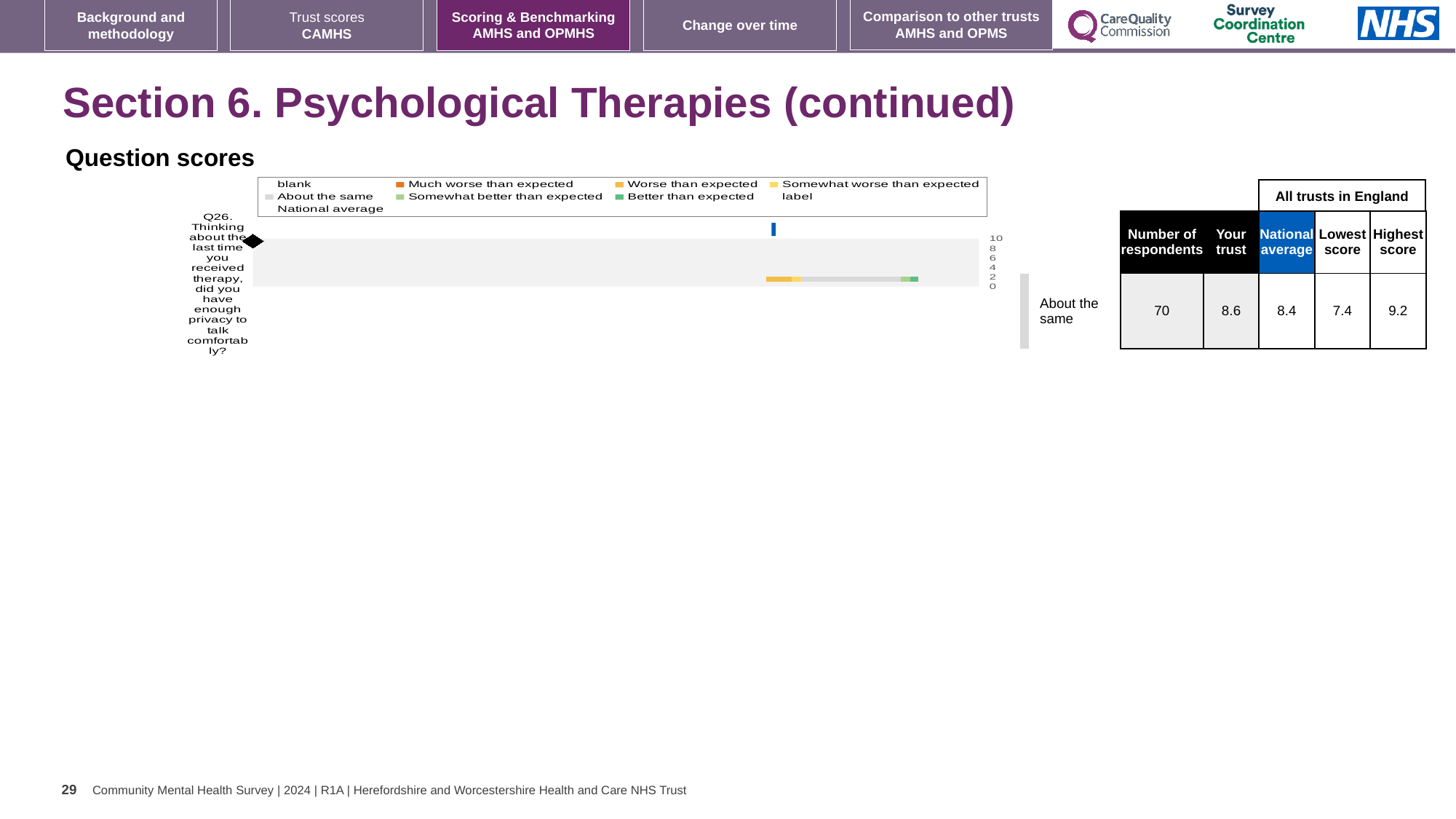
How many respondents answered Q26, according to the table beside the chart? 70 According to the table beside the chart, what is the 'Your trust' score for Q26? 8.6 What is the highest value shown on the chart's score axis? 10 What kind of chart is used to show the Q26 question score? bar chart According to the table beside the chart, what is the lowest score among all trusts in England for Q26? 7.4 Is the trust's score for Q26 higher or lower than the national average? higher What benchmark category is the trust's Q26 score placed in? About the same How many questions are plotted on the chart? 1 What is the difference between the highest score and the lowest score for Q26 in the table beside the chart? 1.8 According to the table beside the chart, what is the national average score for Q26? 8.4 According to the table beside the chart, what is the highest score among all trusts in England for Q26? 9.2 Which question number is plotted on the chart? Q26